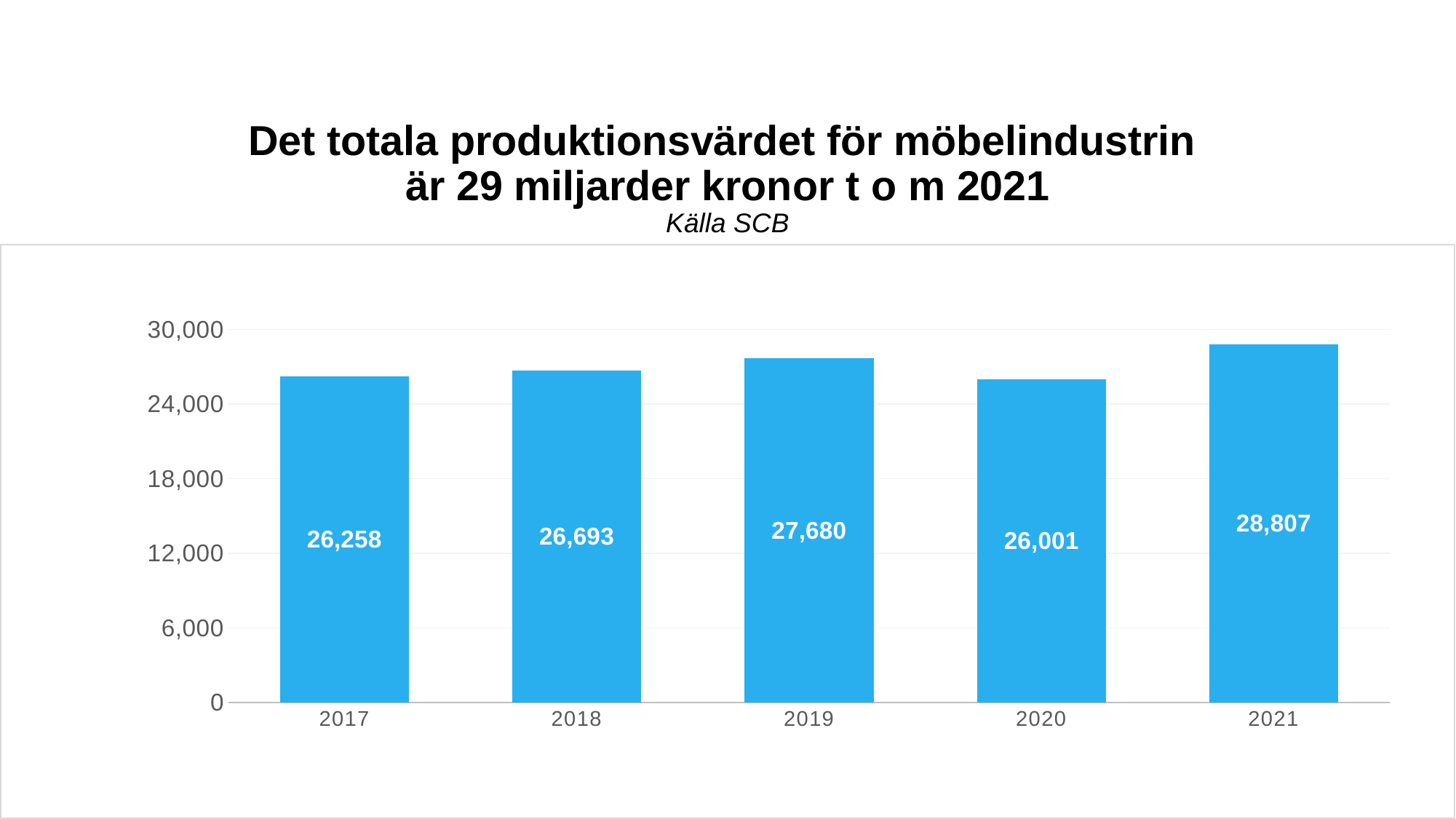
Which is larger, the value for 2019 or the value for 2018? 2019 What source is cited below the chart title? SCB Which year has the lowest value? 2020 What is the difference between the values for 2021 and 2020? 2,806 How many years are shown on the x axis? 5 What is the value for 2017? 26,258 What is the difference between the values for 2018 and 2017? 435 What is the value for 2019? 27,680 Is the value for 2021 greater or less than 24,000? greater What kind of chart is shown on the slide? bar chart What is the value for 2021? 28,807 Which year has the highest value? 2021